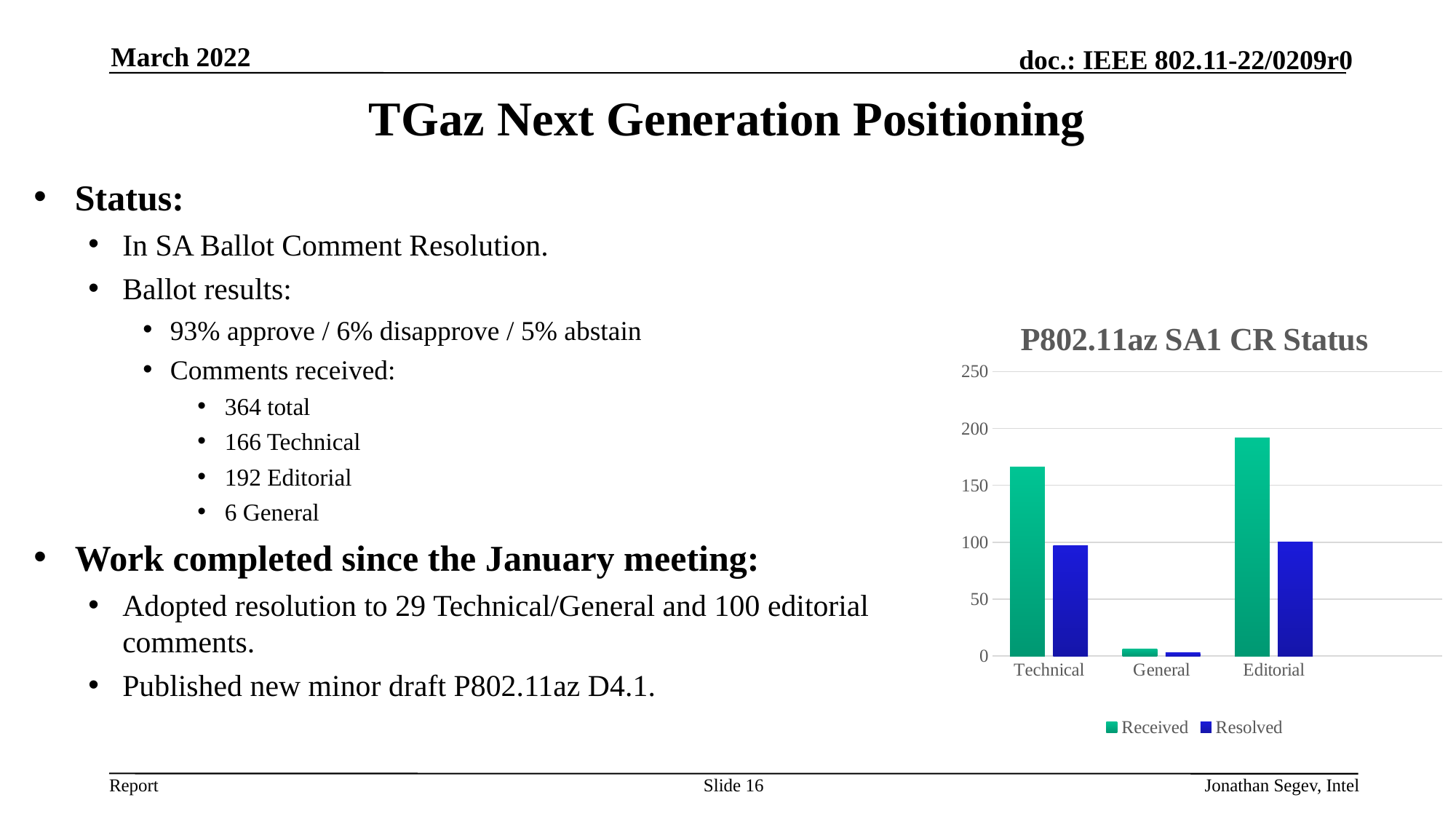
Is the Received value for Technical greater or less than 150? greater Which is larger, the Received value for Editorial or the Received value for Technical? Editorial Is the Received value for Technical greater or less than 200? less Which category has the highest Received value? Editorial Which category has the lowest Received value? General For the Technical category, which is larger, Received or Resolved? Received What kind of chart is shown on the slide? bar chart How many categories are shown on the x axis of the chart? 3 What is the title of the chart? P802.11az SA1 CR Status Is the Received value for Editorial greater or less than 150? greater How many series does the chart legend list? 2